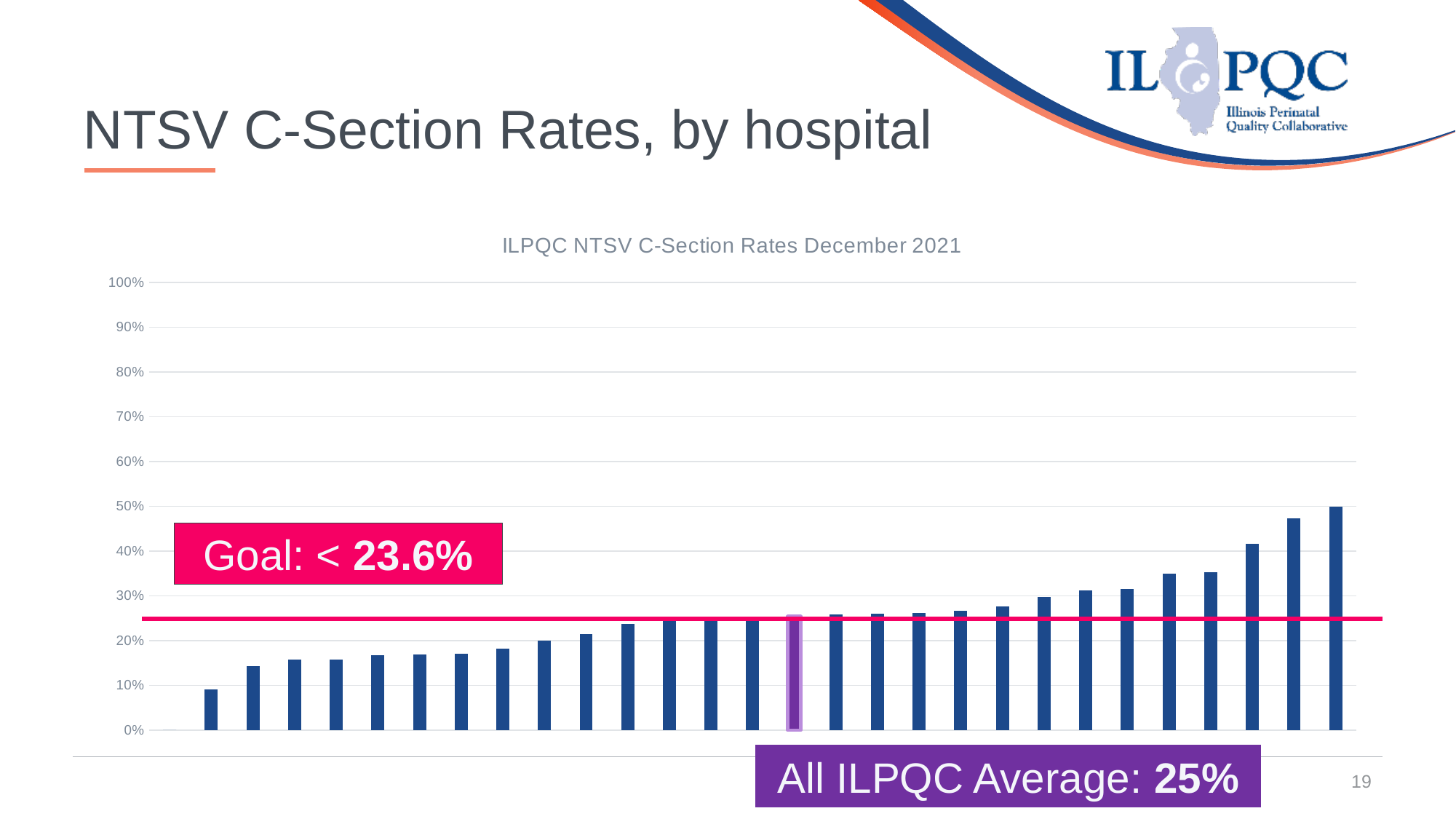
Which bar is the tallest, the leftmost or the rightmost? rightmost What kind of chart is shown on the slide? bar chart Do the bar values rise or fall from left to right across the chart? rise What is the All ILPQC Average shown on the slide? 25% Is the value of the rightmost bar greater or less than 40%? greater What is the title of the chart? ILPQC NTSV C-Section Rates December 2021 How many hospital bars are plotted in the chart? 28 Is the value of the second bar from the left greater or less than 20%? less Is the value of the highlighted purple bar greater or less than 40%? less What goal value is shown in the red box on the chart? < 23.6% What is the highest value shown on the y-axis? 100%